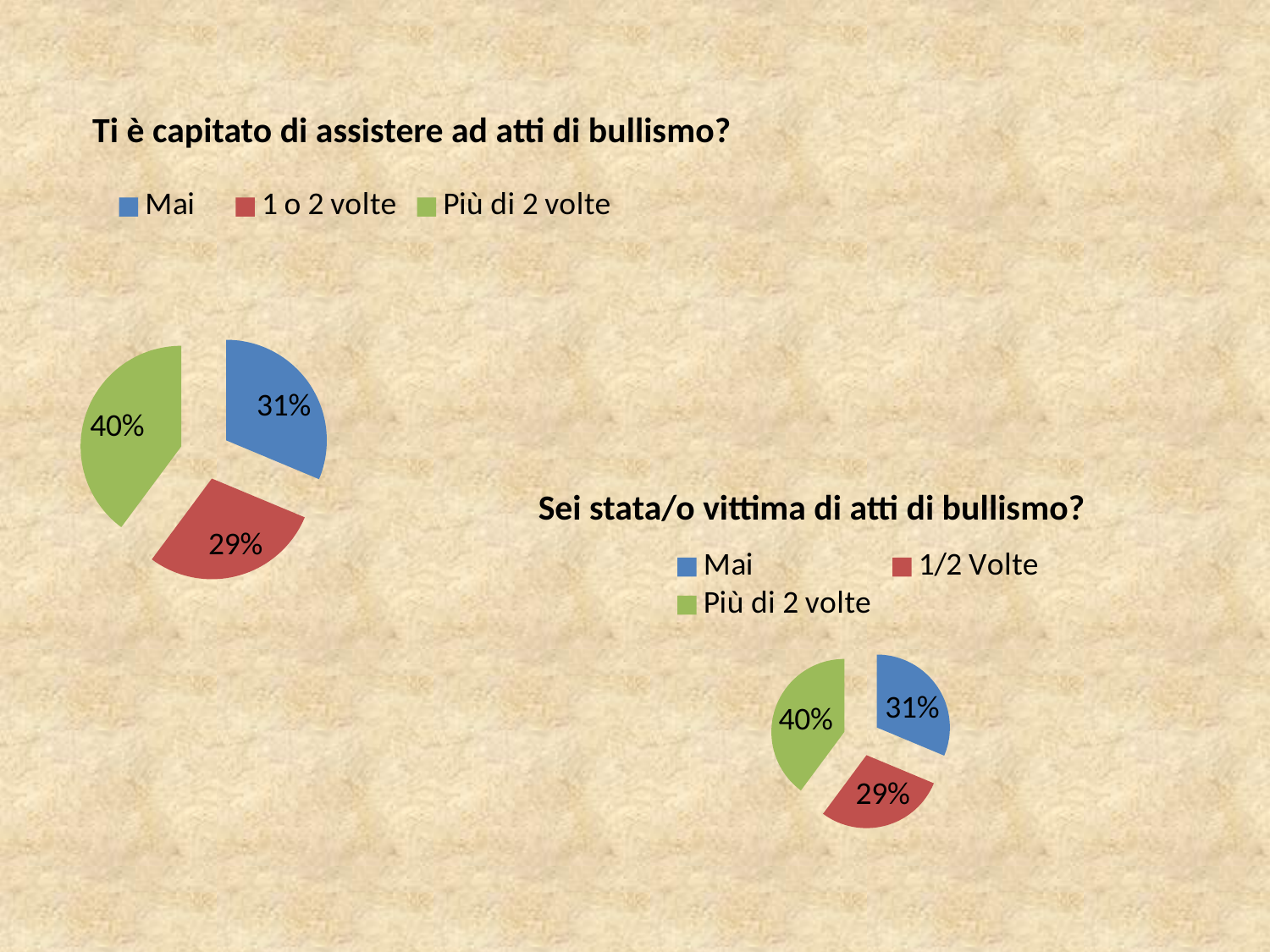
In the chart titled "Sei stata/o vittima di atti di bullismo?", how many categories does the legend list? 3 In the chart titled "Sei stata/o vittima di atti di bullismo?", which category has the largest share? Più di 2 volte In the chart titled "Ti è capitato di assistere ad atti di bullismo?", what percentage is shown for "1 o 2 volte"? 29% In the chart titled "Sei stata/o vittima di atti di bullismo?", what colour is the slice for "Più di 2 volte"? Green In the chart titled "Ti è capitato di assistere ad atti di bullismo?", which category has the largest share? Più di 2 volte In the chart titled "Ti è capitato di assistere ad atti di bullismo?", what percentage is shown for "Più di 2 volte"? 40% In the chart titled "Ti è capitato di assistere ad atti di bullismo?", which category has the smallest share? 1 o 2 volte In the chart titled "Ti è capitato di assistere ad atti di bullismo?", what is the difference in percentage points between "Più di 2 volte" and "Mai"? 9% In the chart titled "Sei stata/o vittima di atti di bullismo?", what percentage is shown for "Mai"? 31% In the chart titled "Sei stata/o vittima di atti di bullismo?", what percentage is shown for "1/2 Volte"? 29% In the chart titled "Ti è capitato di assistere ad atti di bullismo?", what percentage is shown for "Mai"? 31% What kind of chart is used for "Sei stata/o vittima di atti di bullismo?"? Pie chart